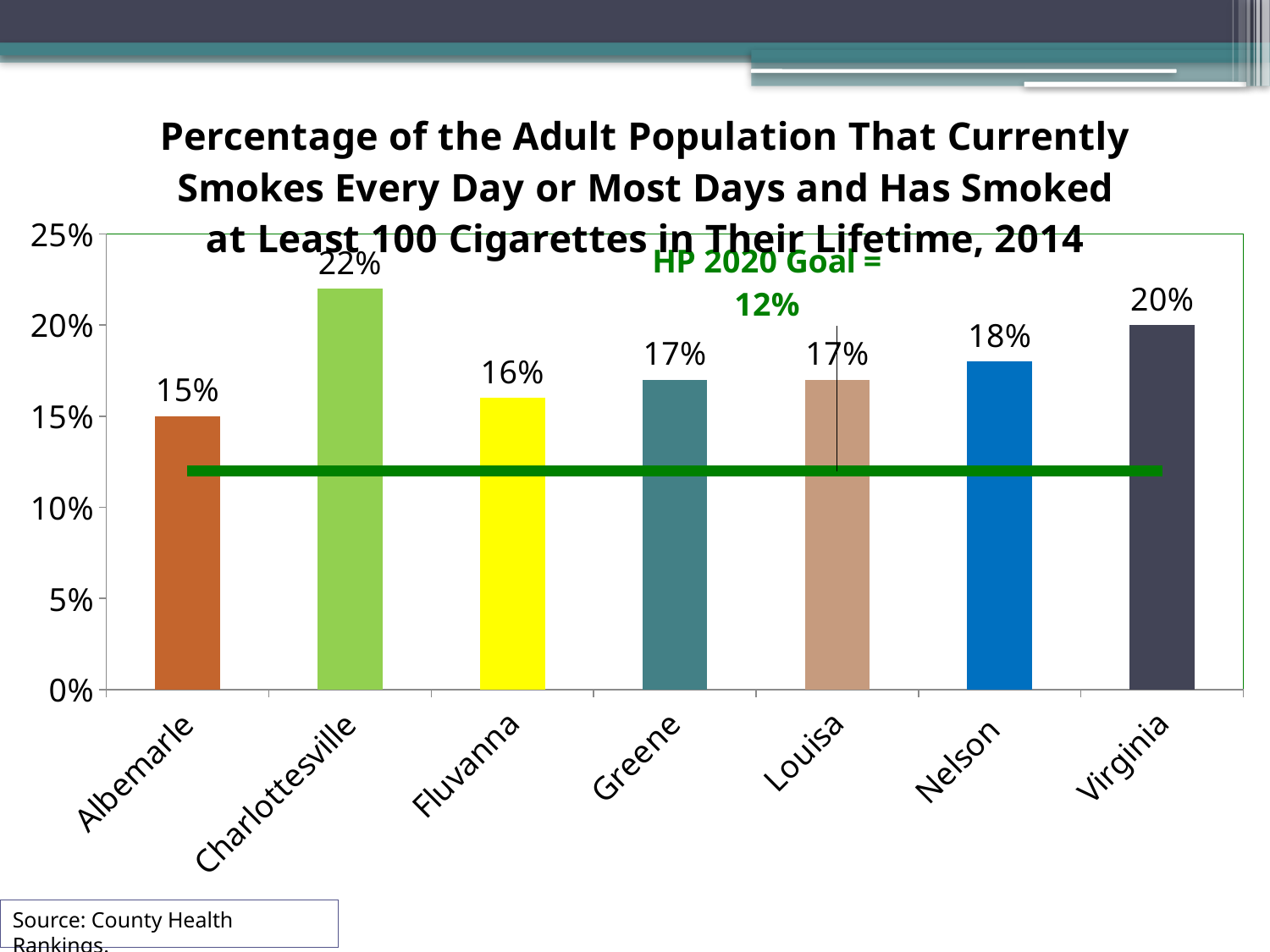
What is the value for Albemarle? 15% What kind of chart is this? combination bar and line chart Which category has the lowest value? Albemarle How many categories are shown on the x axis? 7 What is the value for Nelson? 18% What is the value for Virginia? 20% Which category has the highest value? Charlottesville Which is larger, the value for Virginia or the value for Fluvanna? Virginia What is the difference between the values for Charlottesville and Albemarle? 7% What is the value for Charlottesville? 22% Is the value for Greene greater or less than 15%? greater What is the HP 2020 Goal shown on the chart? 12%